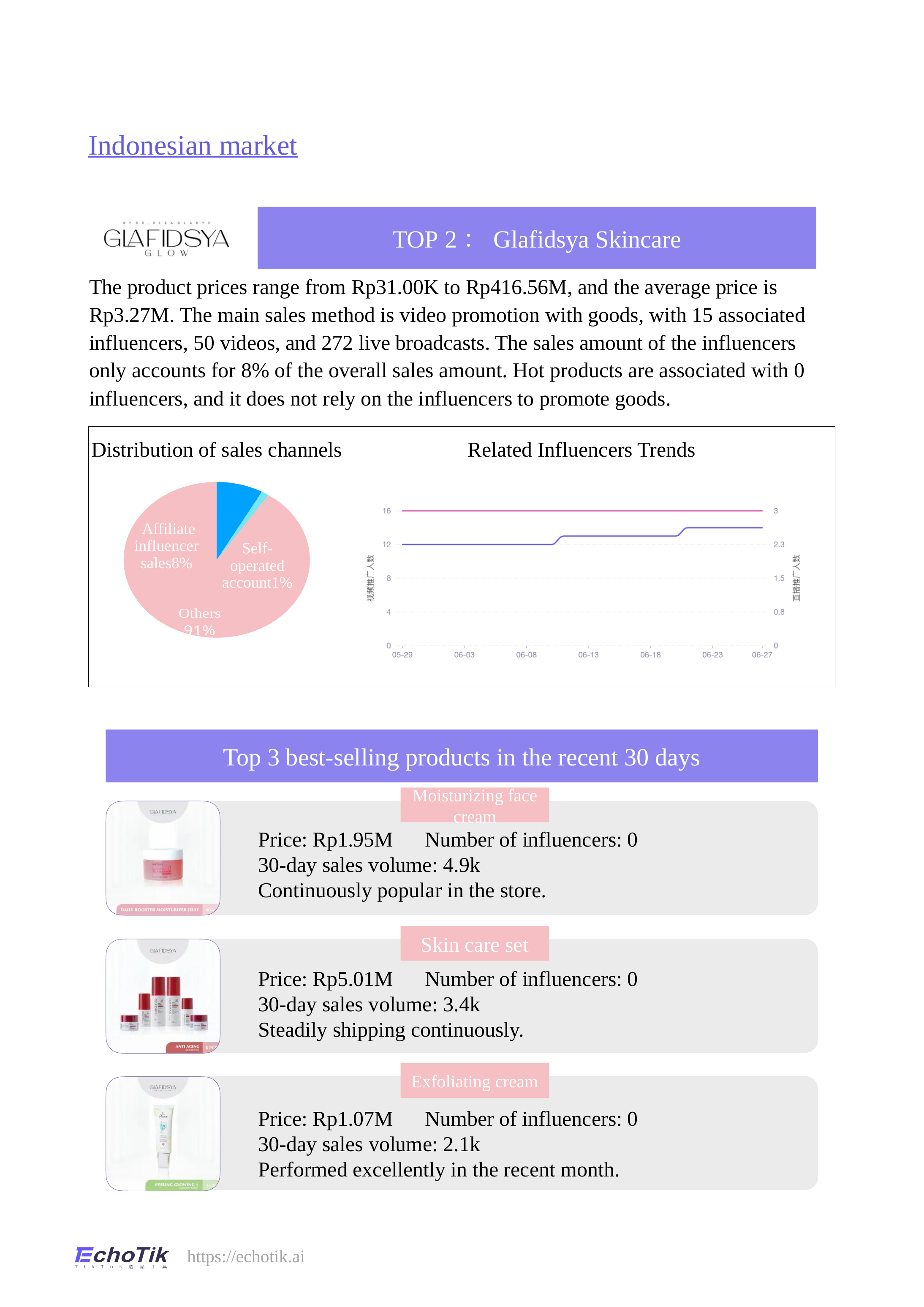
In the Distribution of sales channels chart, what share of sales comes from the Self-operated account? 1% In the Distribution of sales channels chart, what share of sales is labelled Others? 91% In the Related Influencers Trends chart, is the purple line's value on 05-29 greater or less than 8 on the left axis? greater What kind of chart is the Distribution of sales channels chart? Pie chart In the Related Influencers Trends chart, does the purple line rise or fall from 05-29 to 06-27? Rise In the Distribution of sales channels chart, which category has the largest share? Others In the Distribution of sales channels chart, which is larger: Affiliate influencer sales or Self-operated account? Affiliate influencer sales In the Distribution of sales channels chart, how many percentage points larger is Affiliate influencer sales than the Self-operated account? 7 What kind of chart is the Related Influencers Trends chart? Line chart In the Distribution of sales channels chart, what share of sales comes from Affiliate influencer sales? 8% In the Distribution of sales channels chart, which category has the smallest share? Self-operated account How many slices does the Distribution of sales channels pie chart have? 3